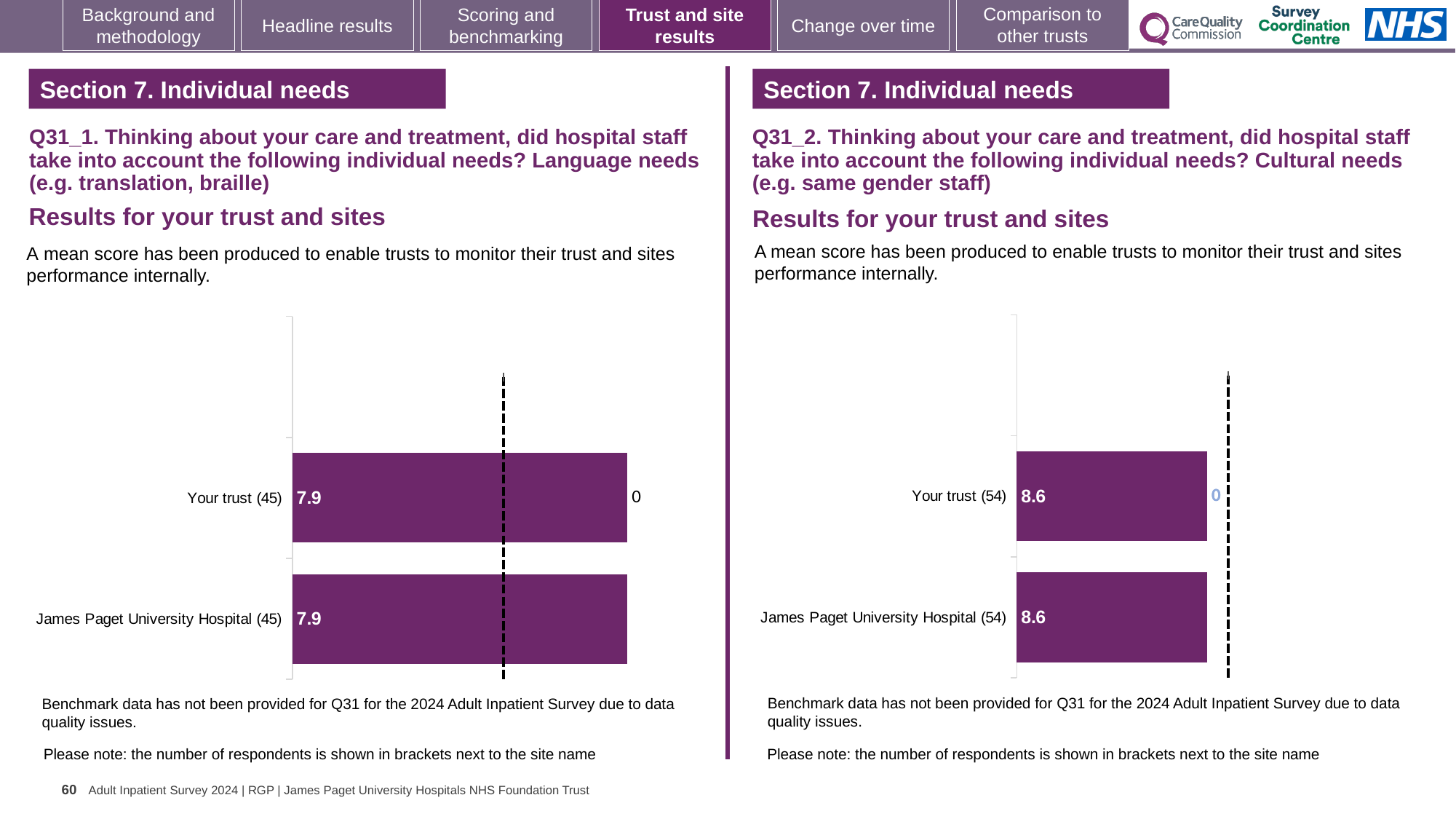
On the right chart (Q31_2, Cultural needs), how many respondents are shown in brackets next to James Paget University Hospital? 54 How many bars are plotted on the right chart (Q31_2, Cultural needs)? 2 On the right chart (Q31_2, Cultural needs), what is the mean score for James Paget University Hospital? 8.6 On the right chart (Q31_2, Cultural needs), what is the mean score for Your trust? 8.6 On the right chart (Q31_2, Cultural needs), what is the difference between the score for Your trust and the score for James Paget University Hospital? 0 On the left chart (Q31_1, Language needs), how many respondents are shown in brackets next to Your trust? 45 How many bars are plotted on the left chart (Q31_1, Language needs)? 2 On the left chart (Q31_1, Language needs), what is the difference between the score for Your trust and the score for James Paget University Hospital? 0 What kind of chart is used on the right side of the slide (Q31_2, Cultural needs)? Bar chart On the left chart (Q31_1, Language needs), what is the mean score for Your trust? 7.9 Which is larger: the Your trust score on the left chart (Q31_1, Language needs) or the Your trust score on the right chart (Q31_2, Cultural needs)? The right chart (Q31_2, Cultural needs), 8.6 On the left chart (Q31_1, Language needs), what is the mean score for James Paget University Hospital? 7.9